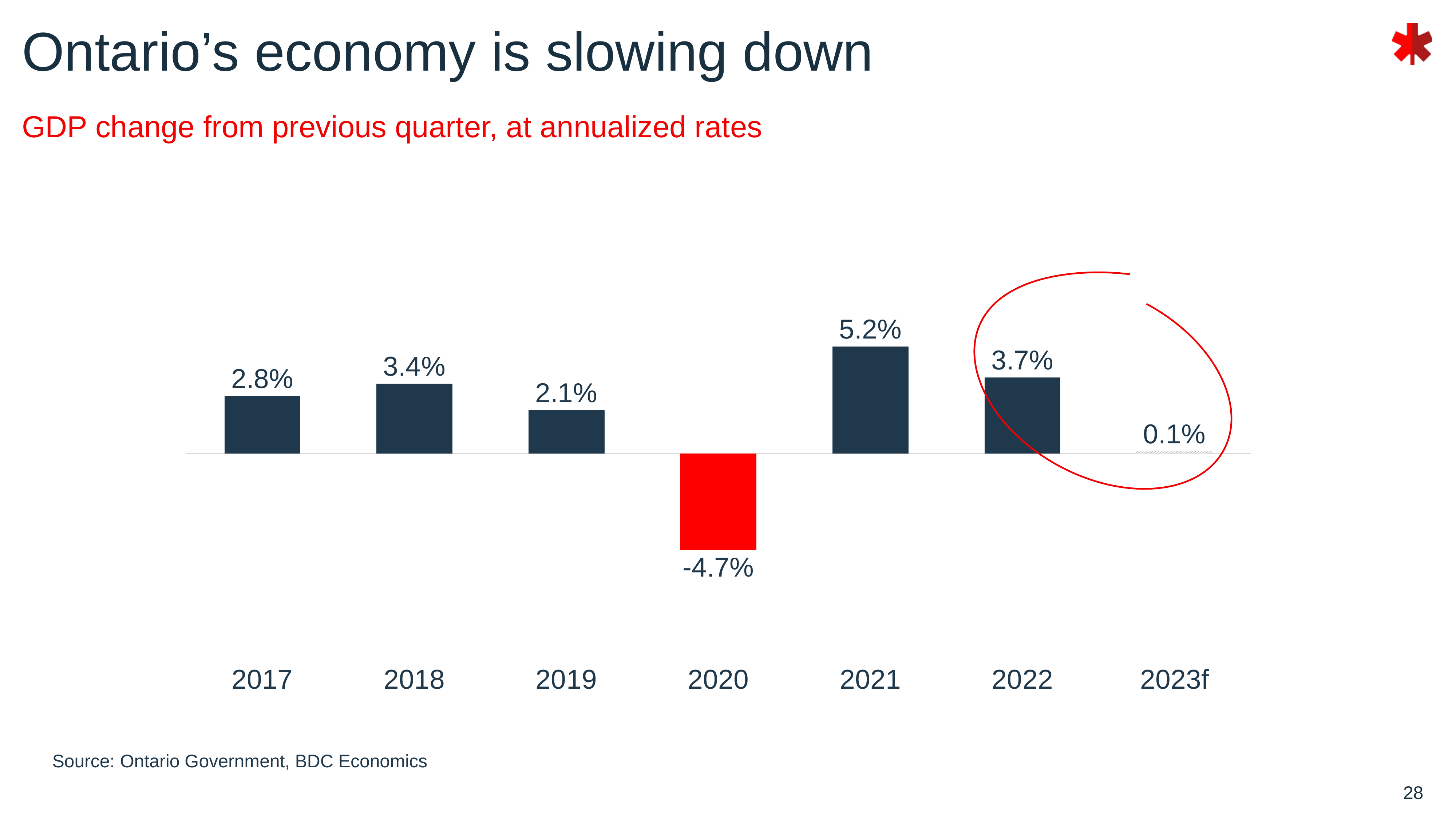
Which year has the highest GDP change value? 2021 What is the GDP change value shown for 2018? 3.4% How many years are shown on the x axis of the chart? 7 Which year has the lowest GDP change value? 2020 What kind of chart is shown on the slide? Bar chart Which year has a larger GDP change value, 2017 or 2019? 2017 What is the forecast GDP change value shown for 2023f? 0.1% What is the GDP change value shown for 2021? 5.2% What is the GDP change value shown for 2020? -4.7% What is the difference between the GDP change values for 2021 and 2022? 1.5% What is the difference between the GDP change values for 2018 and 2017? 0.6% Which year's bar is coloured red in the chart? 2020